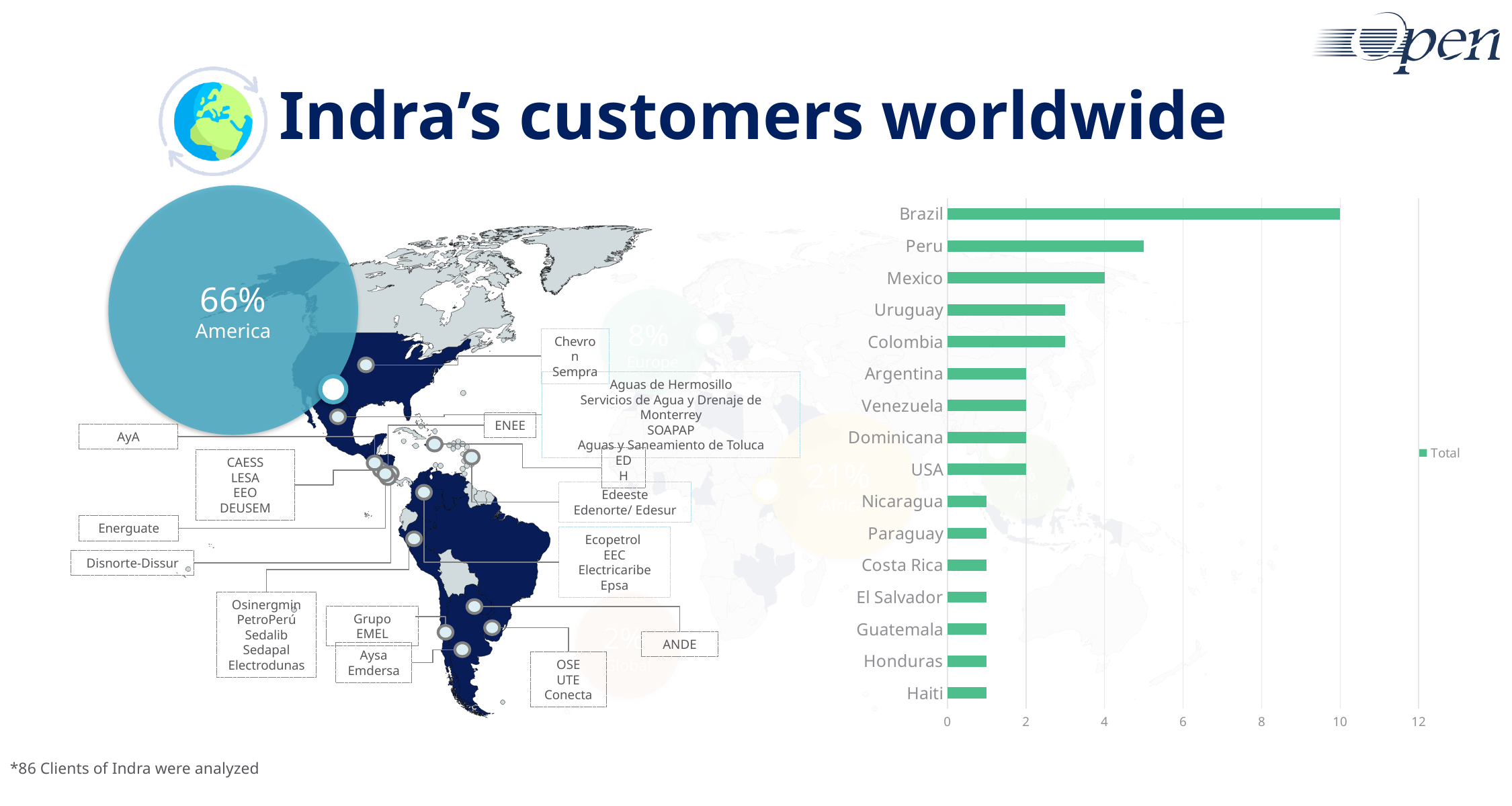
What type of chart is shown on the right side of the slide? bar chart In the bar chart, what is the value for Brazil? 10 In the bar chart, what is the value for Argentina? 2 In the bar chart, is the value for Peru greater or less than 4? greater In the bar chart, what is the difference between the values for Brazil and Mexico? 6 In the bar chart, what is the value for USA? 2 In the bar chart, which country has the highest value? Brazil How many series does the bar chart's legend list? 1 In the bar chart, which is larger, the value for Mexico or the value for Uruguay? Mexico In the bar chart, is the value for Nicaragua greater or less than 2? less How many countries are listed in the bar chart? 16 In the bar chart, what is the value for Mexico? 4